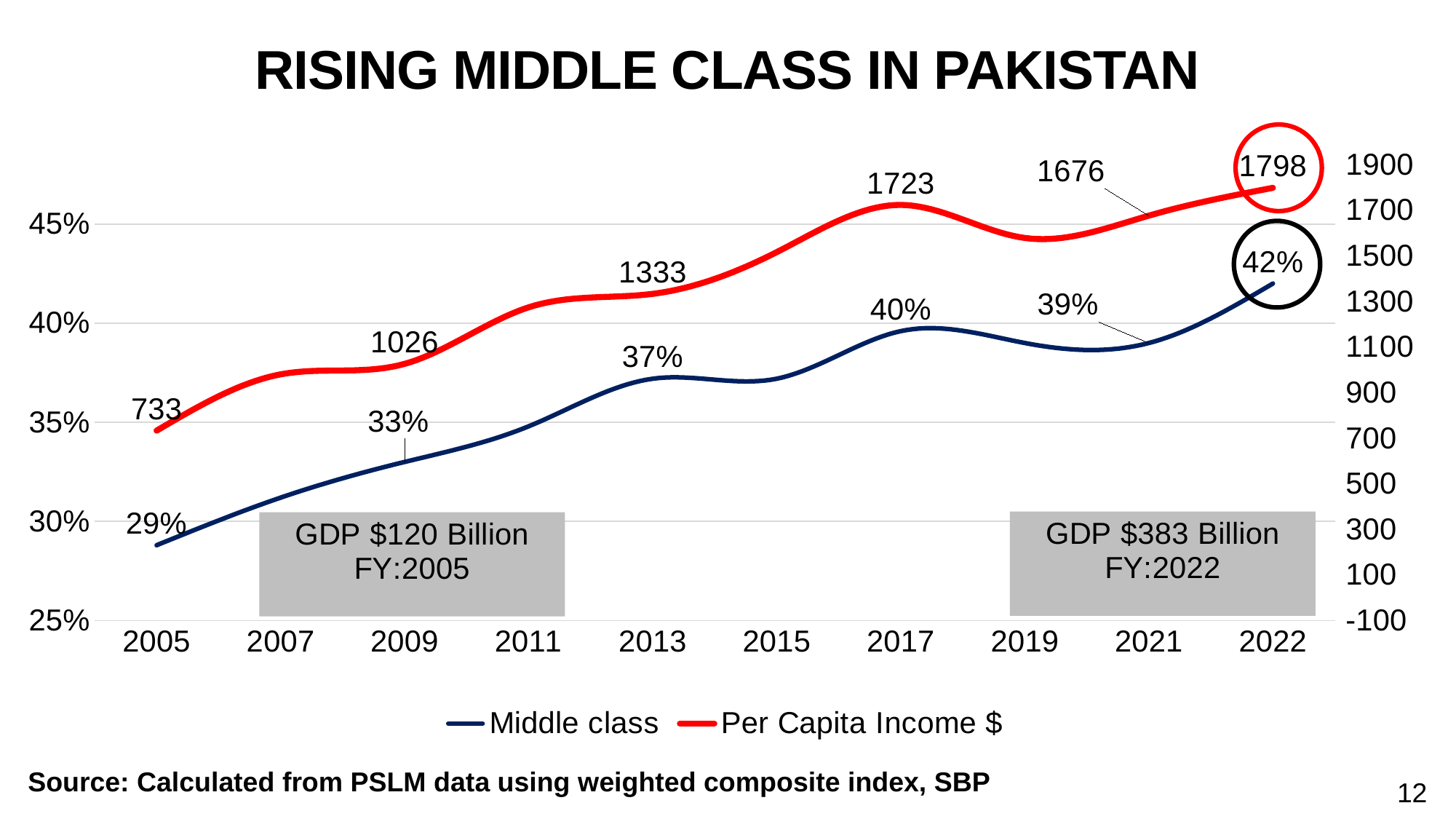
What is the difference between the Per Capita Income $ values for 2022 and 2005? 1065 What is the title of the chart? RISING MIDDLE CLASS IN PAKISTAN What is the Middle class value for 2005? 29% What is the Per Capita Income $ value for 2013? 1333 What type of chart is shown on the slide? line chart Which is larger, the Per Capita Income $ value for 2017 or for 2021? 2017 Does the Middle class line generally rise or fall from 2005 to 2022? rise Which year has the lowest labelled Middle class value? 2005 Which year has the highest labelled Per Capita Income $ value? 2022 What is the Middle class value for 2017? 40% What is the Per Capita Income $ value for 2022? 1798 How many series does the legend list? 2